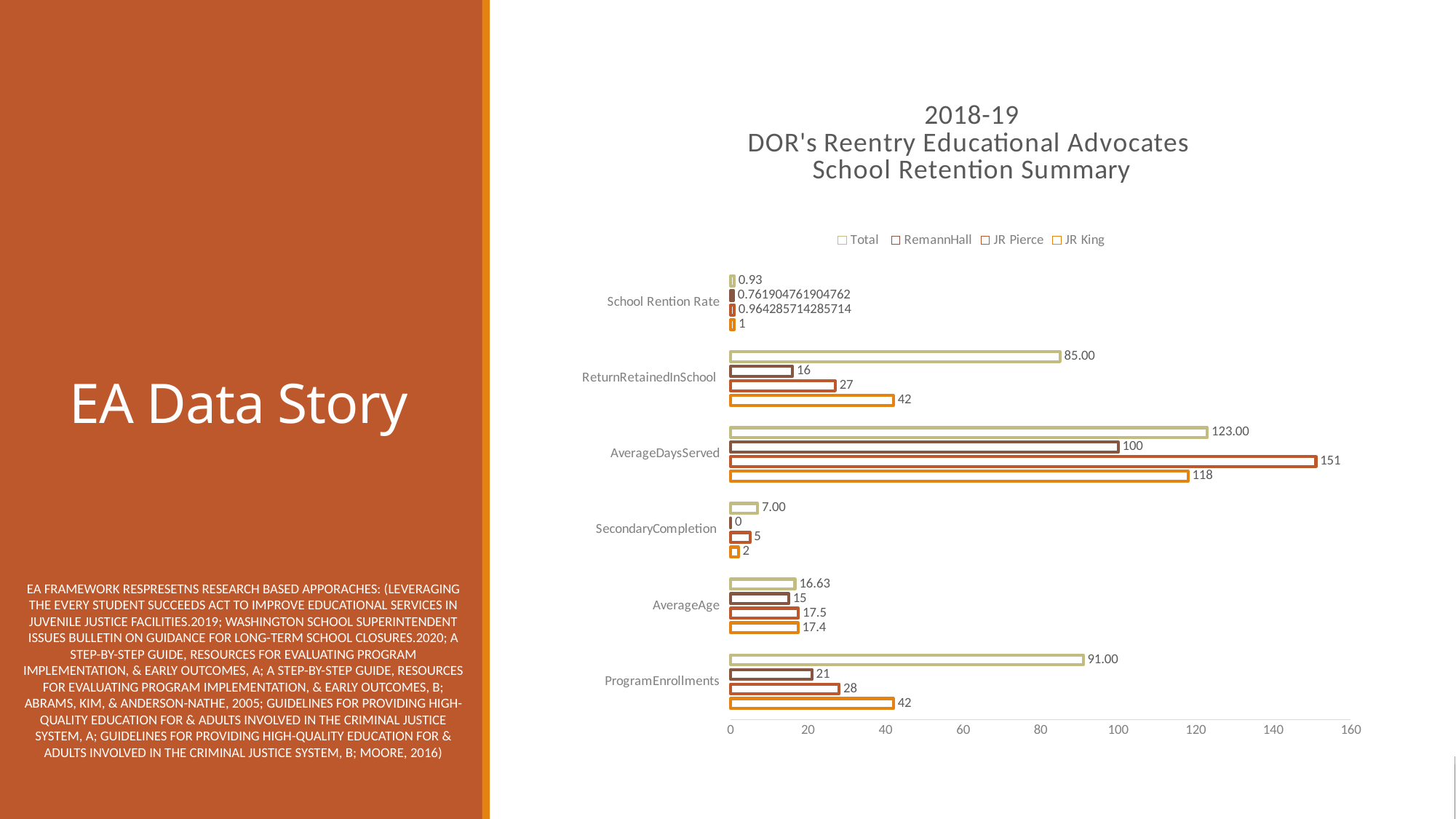
What type of chart is shown on the slide? bar chart What is the JR Pierce value for AverageDaysServed? 151 Which is larger for AverageAge: the JR Pierce value or the RemannHall value? JR Pierce Which series has the highest value for AverageDaysServed? JR Pierce What is the title of the chart? 2018-19 DOR's Reentry Educational Advocates School Retention Summary How many categories are shown on the vertical axis? 6 Which series has the lowest value for SecondaryCompletion? RemannHall What is the JR King value for ProgramEnrollments? 42 What is the difference between the JR King and JR Pierce values for ReturnRetainedInSchool? 15 What is the RemannHall value for ReturnRetainedInSchool? 16 How many series does the legend list? 4 What is the Total value for AverageDaysServed? 123.00